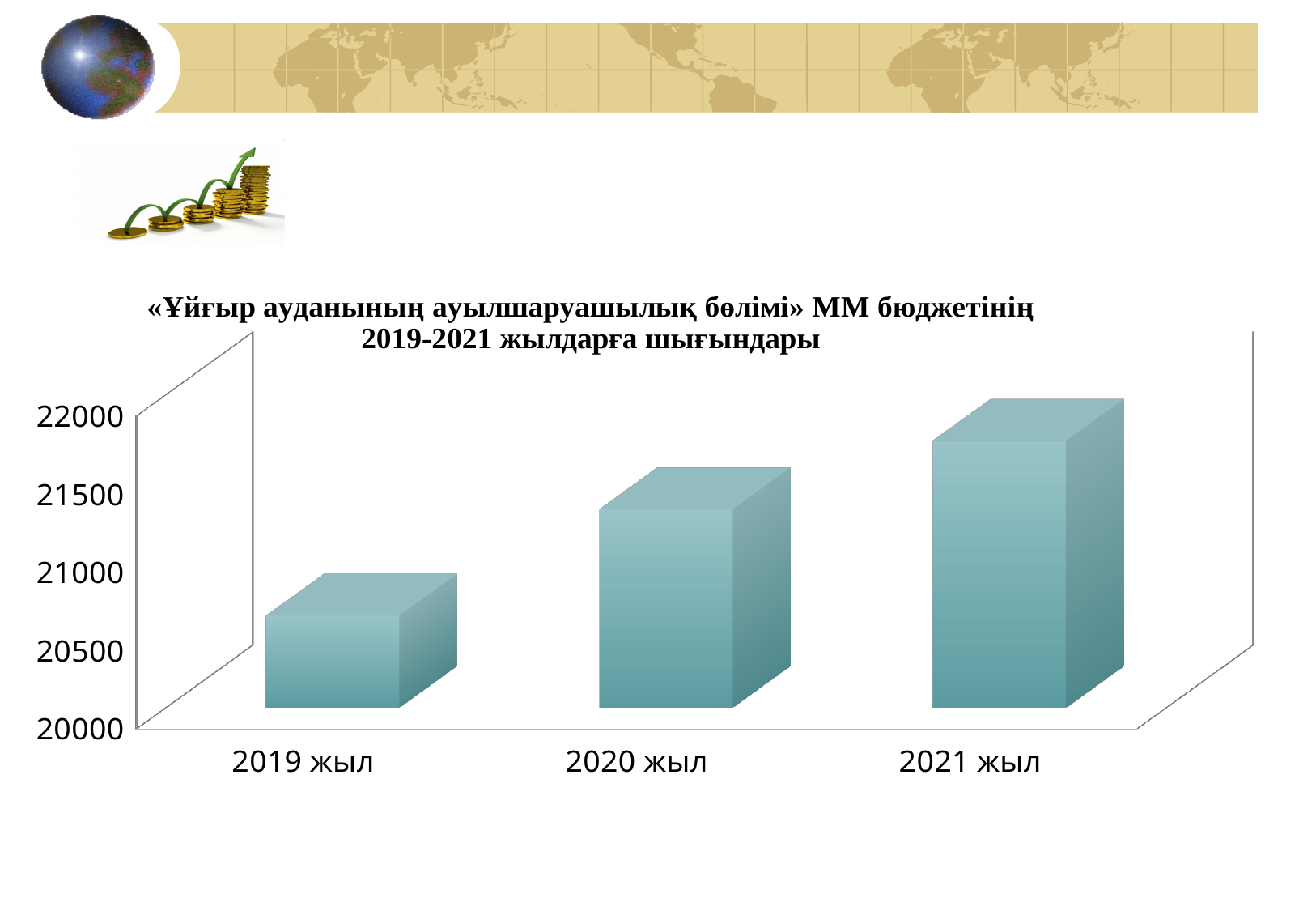
Is the value for 2020 жыл greater or less than 22000? less What kind of chart is shown on the slide? bar chart Which year has the highest value in the chart? 2021 жыл Is the value for 2021 жыл greater or less than 21500? greater Which year has the lowest value in the chart? 2019 жыл Which is larger, the value for 2019 жыл or the value for 2020 жыл? 2020 жыл What years does the chart title say the budget expenditures cover? 2019-2021 Is the value for 2020 жыл greater or less than 21000? greater Which is larger, the value for 2020 жыл or the value for 2021 жыл? 2021 жыл How many categories (years) are plotted in the chart? 3 Do the values rise or fall from 2019 жыл to 2021 жыл? rise